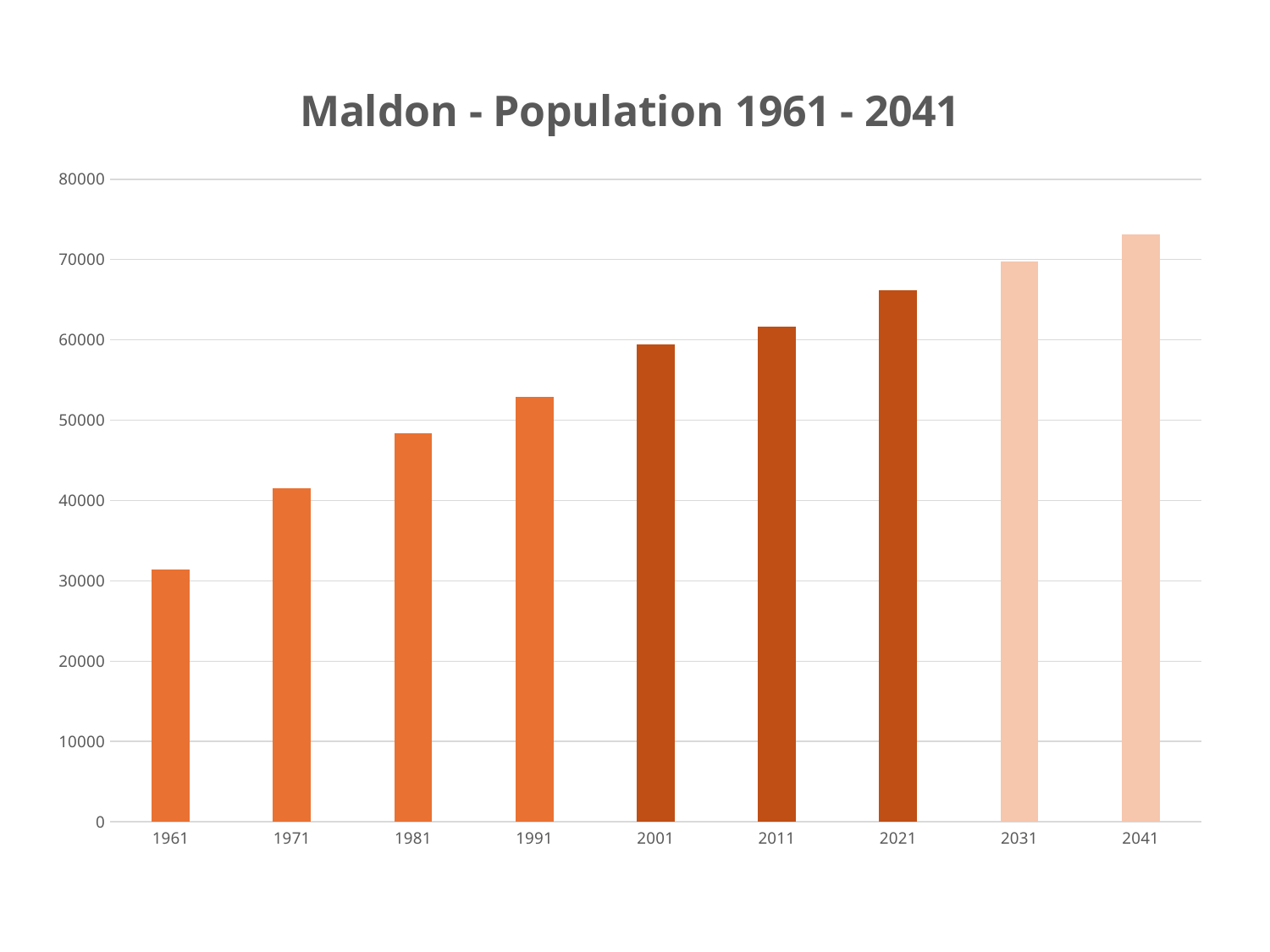
Is the value for 1991 greater or less than 50000? greater Which year has the larger population, 1991 or 2021? 2021 Is the value for 2021 greater or less than 60000? greater Which two years are shown with the lightest-coloured bars? 2031 and 2041 Which year has the lowest population bar? 1961 Is the value for 2041 greater or less than 70000? greater Do the population values rise or fall from 1961 to 2041? rise What is the title of the chart? Maldon - Population 1961 - 2041 Which year has the highest population bar? 2041 What kind of chart is shown on the slide? bar chart How many years are shown on the x axis of the chart? 9